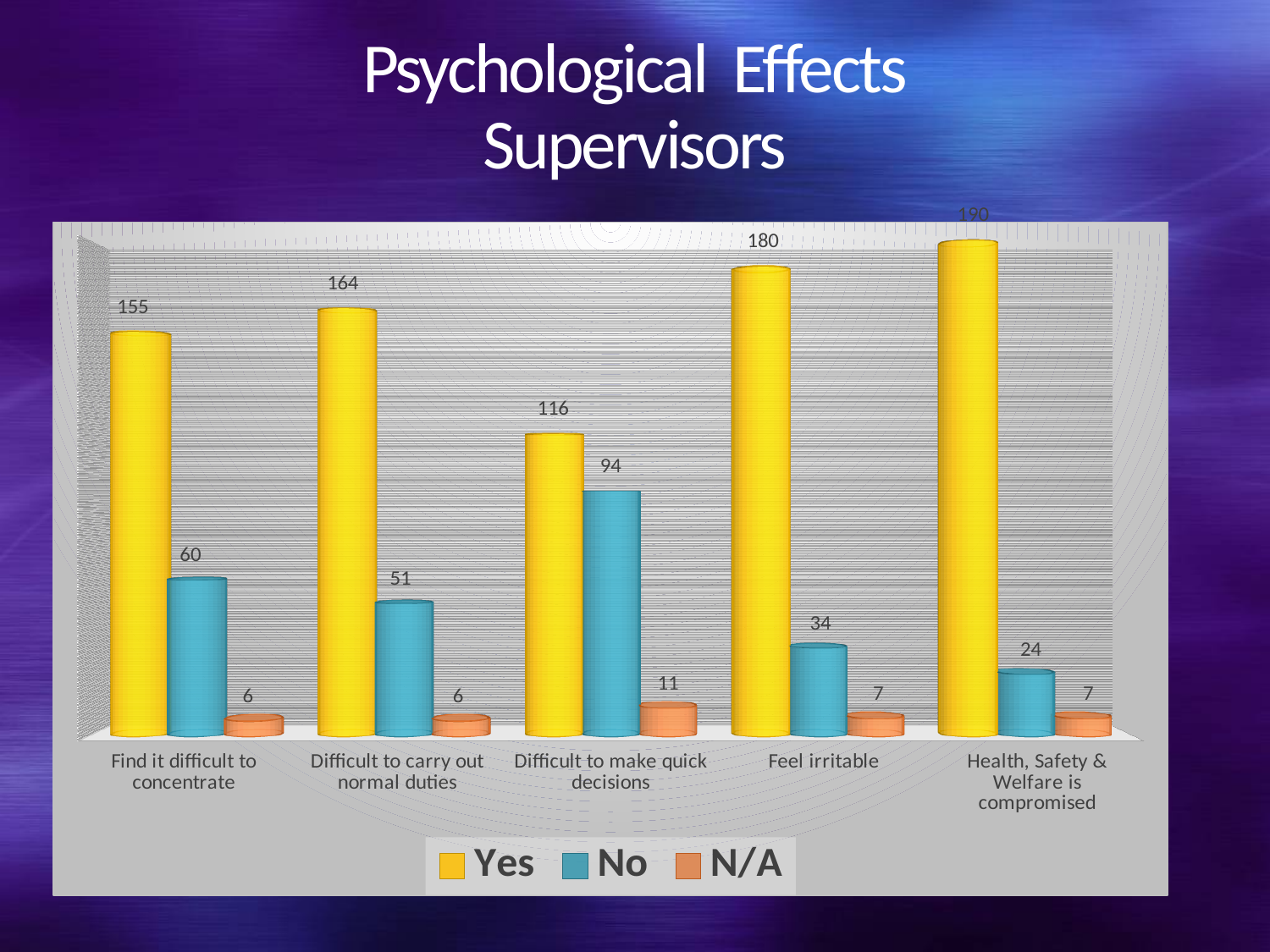
What is the total of the Yes, No and N/A values for Difficult to make quick decisions? 221 Which category has the lowest No value? Health, Safety & Welfare is compromised How many categories are shown on the x axis? 5 What is the difference between the Yes and No values for Find it difficult to concentrate? 95 Which series is shown in yellow in the legend? Yes Which is larger: the No value for Difficult to carry out normal duties or the No value for Feel irritable? Difficult to carry out normal duties What is the No value for Difficult to make quick decisions? 94 What is the Yes value for Feel irritable? 180 What kind of chart is shown on the slide? Bar chart How many series does the legend list? 3 Which category has the highest Yes value? Health, Safety & Welfare is compromised What is the N/A value for Health, Safety & Welfare is compromised? 7